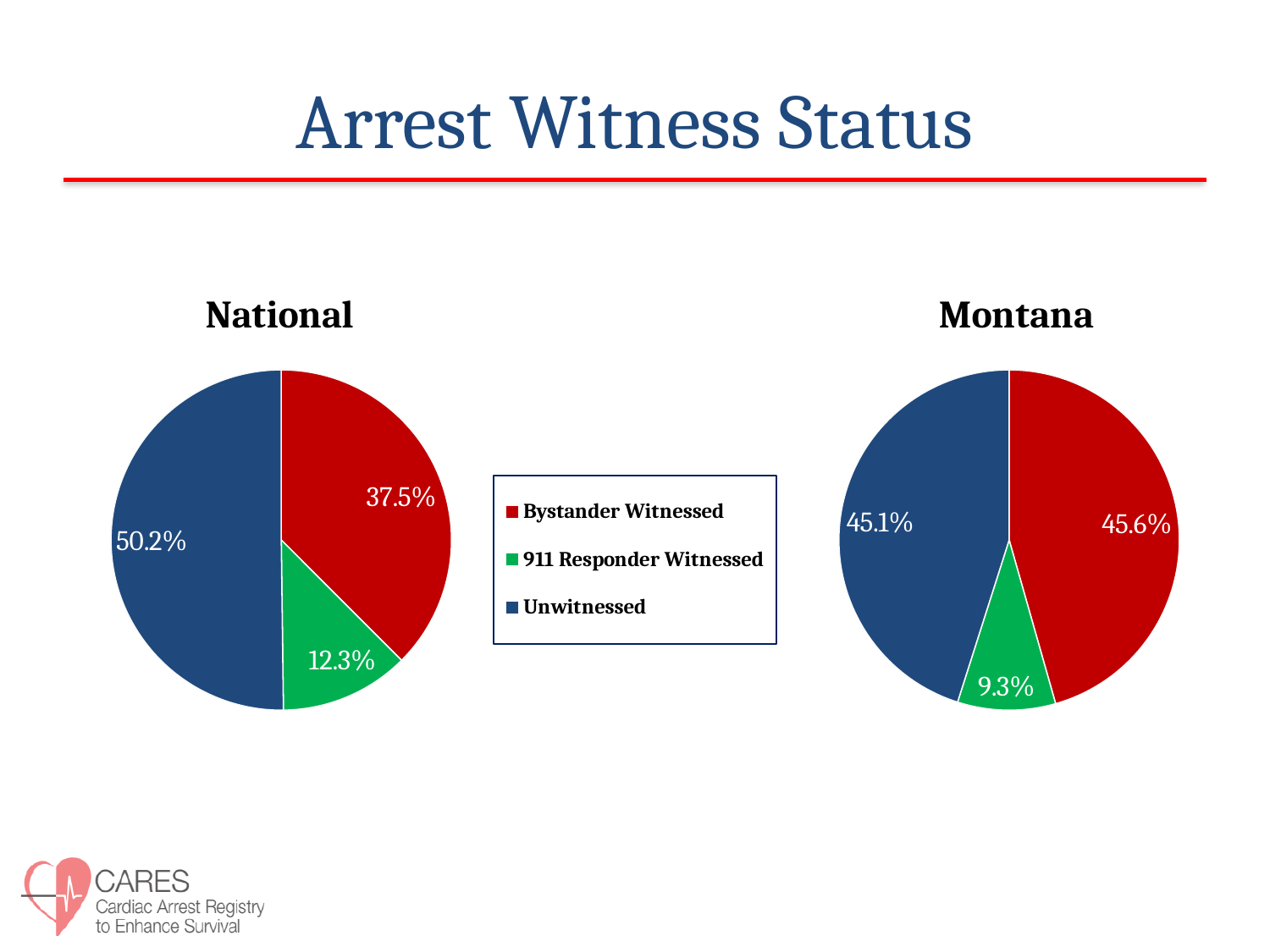
Is the 911 Responder Witnessed share larger in the National chart or the Montana chart? National In the National pie chart, what percentage is 911 Responder Witnessed? 12.3% In the Montana pie chart, what percentage is Bystander Witnessed? 45.6% How many categories does the legend list? 3 In the Montana pie chart, what percentage is Unwitnessed? 45.1% What type of chart is used for the National and Montana data? Pie chart In the National pie chart, what percentage is Bystander Witnessed? 37.5% In the Montana pie chart, what percentage is 911 Responder Witnessed? 9.3% In the National pie chart, what percentage is Unwitnessed? 50.2% In the Montana pie chart, which category has the smallest share? 911 Responder Witnessed In the National pie chart, which category has the largest share? Unwitnessed What is the difference between the Bystander Witnessed percentage in the Montana chart and in the National chart? 8.1%